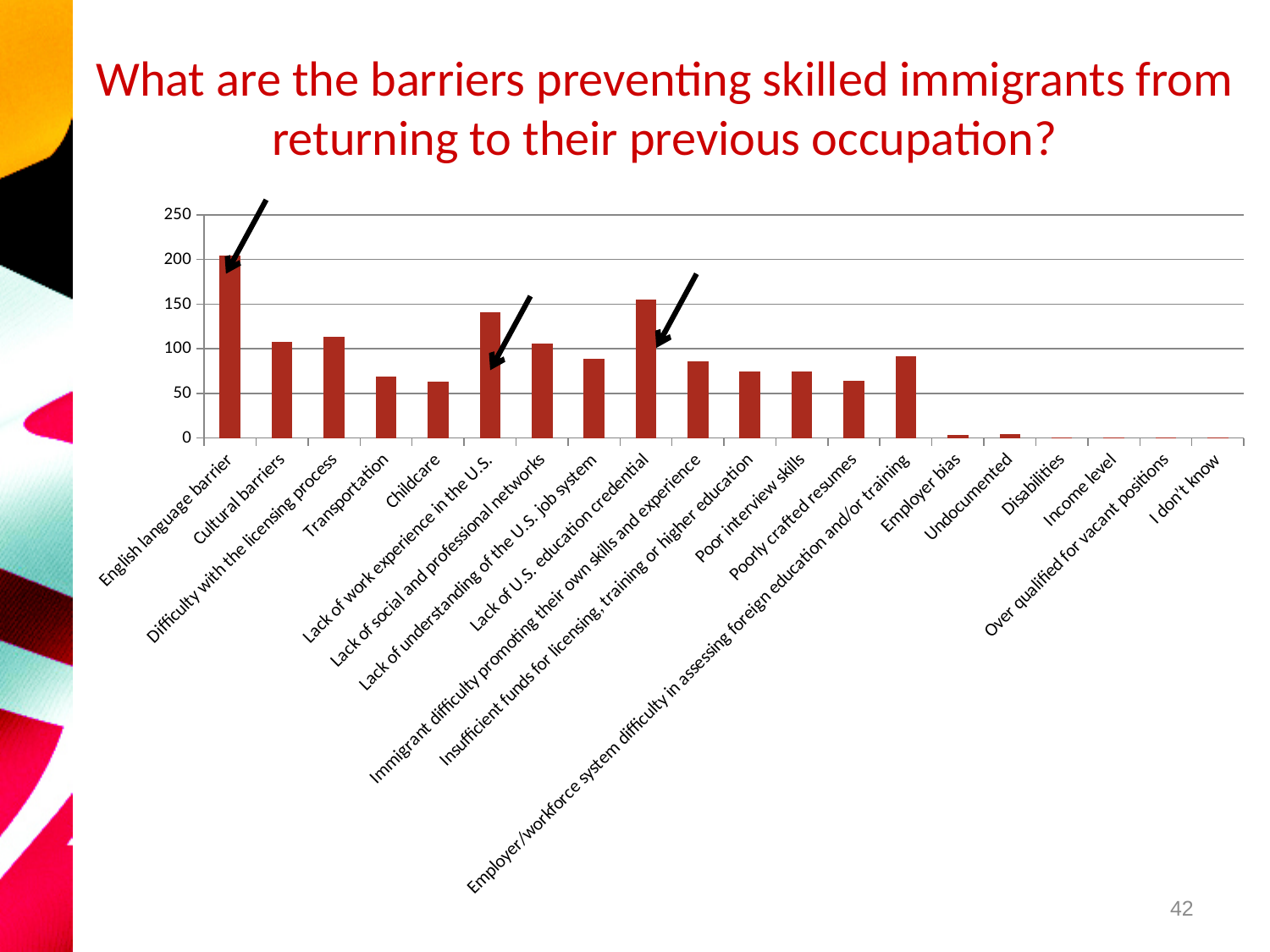
What kind of chart is shown on the slide? Bar chart Which barrier has the highest bar in the chart? English language barrier How many barrier categories are shown along the x axis? 20 Which is larger, the value for Lack of U.S. education credential or the value for Lack of work experience in the U.S.? Lack of U.S. education credential What is the highest value shown on the y axis of the chart? 250 Is the value for Lack of U.S. education credential greater or less than 100? greater Is the value for Employer bias greater or less than 50? less Which is larger, the value for English language barrier or the value for Cultural barriers? English language barrier Is the value for Lack of work experience in the U.S. greater or less than 100? greater Which is larger, the value for Lack of social and professional networks or the value for Lack of understanding of the U.S. job system? Lack of social and professional networks